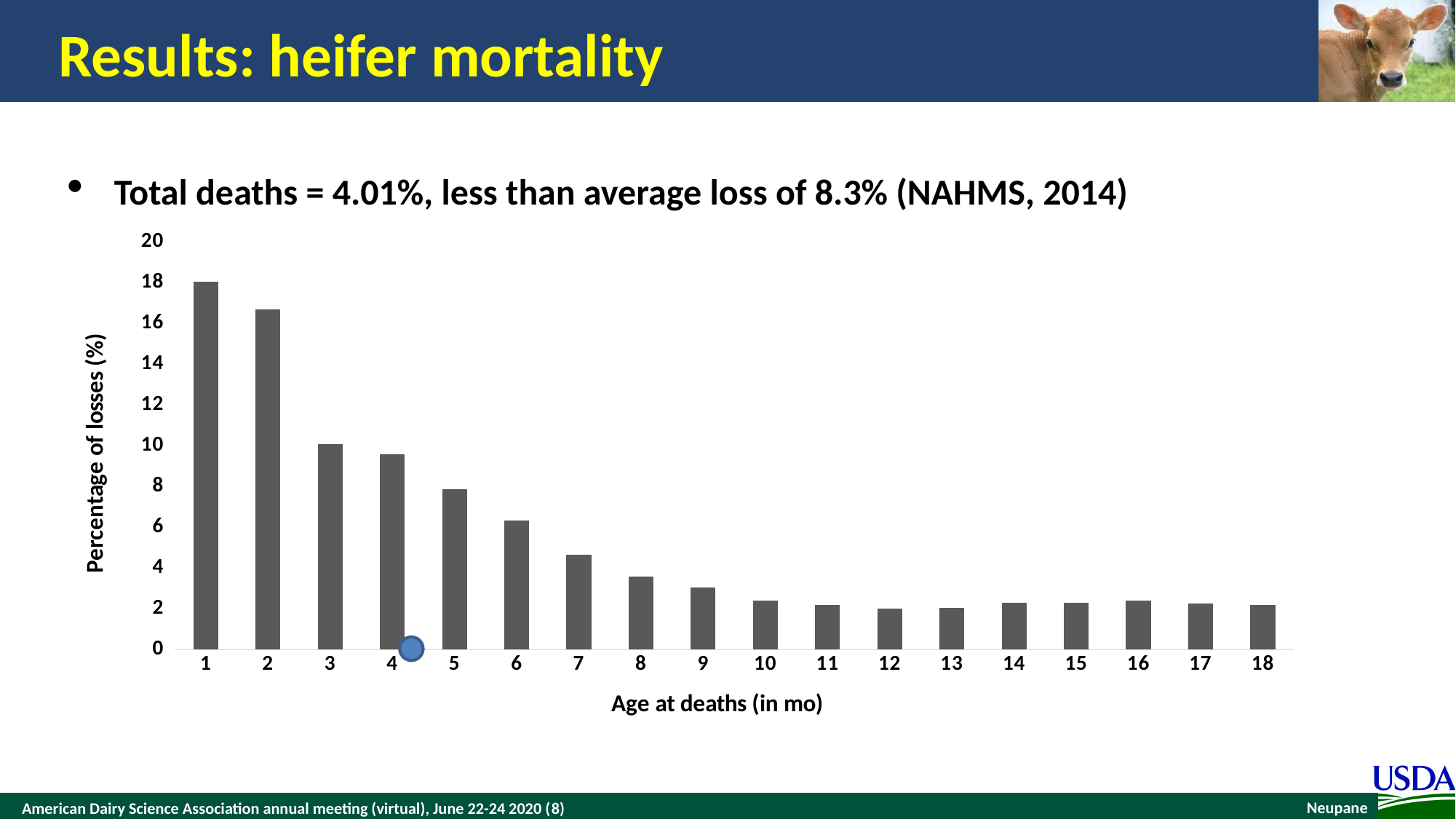
Do the percentages of losses generally rise or fall as age at death increases from 1 to 9 months? fall How many age categories are shown on the x axis of the chart? 18 Is the percentage of losses at age 2 months greater or less than 16? greater Is the percentage of losses at age 4 months greater or less than 8? greater Which age at death (in months) has the highest percentage of losses? 1 Is the percentage of losses at age 6 months greater or less than 6? greater Which has a higher percentage of losses: age 3 months or age 7 months? 3 months What is the label of the y axis of the chart? Percentage of losses (%) Which has a higher percentage of losses: age 9 months or age 2 months? 2 months What type of chart is shown on the slide? bar chart